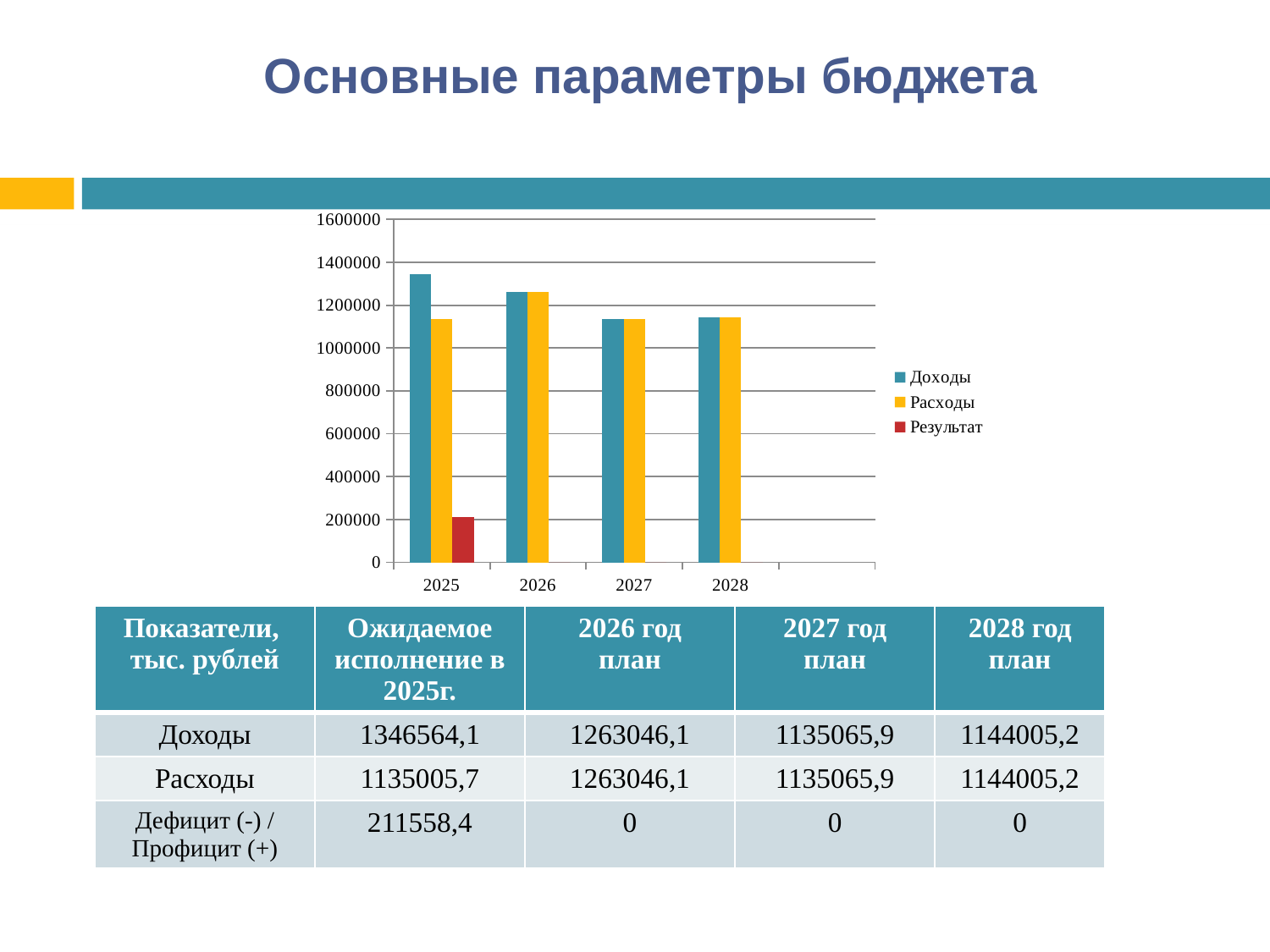
In which year is the Доходы bar the highest? 2025 Is the value of Расходы for 2025 greater or less than 1200000? less How many series does the chart legend list? 3 How many years are shown on the x axis of the chart? 4 According to the table on the slide, what is the planned value of Доходы for 2026 (тыс. рублей)? 1263046,1 According to the table on the slide, what is the difference between Доходы and Расходы in 2025 (тыс. рублей)? 211558,4 In 2025, which is larger, Доходы or Расходы? Доходы What kind of chart is shown on the slide? bar chart Is the value of Результат for 2025 greater or less than 400000? less Do the Доходы values rise or fall from 2025 to 2027? fall Is the value of Доходы for 2025 greater or less than 1200000? greater Which legend entry is shown in red in the chart? Результат